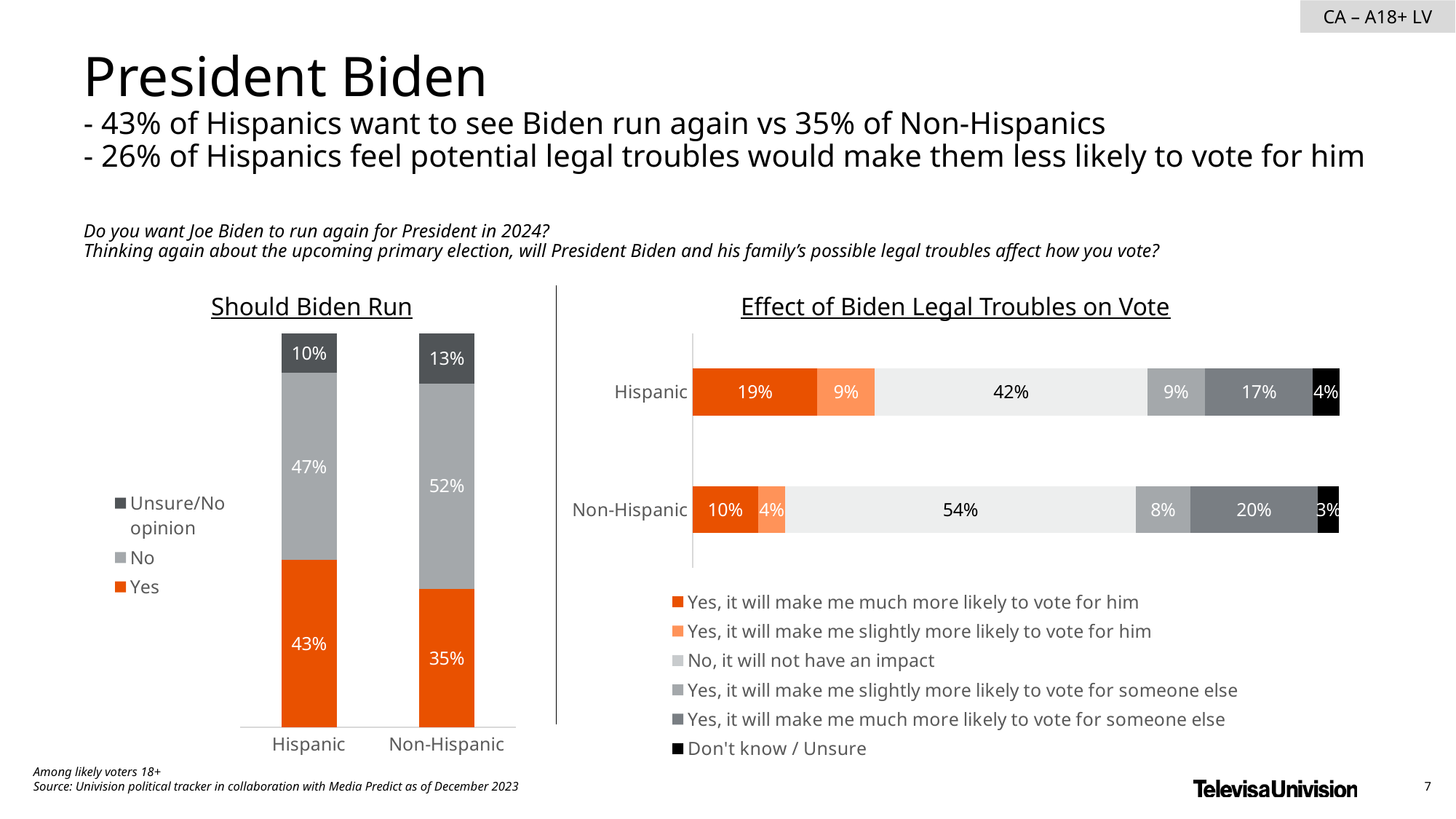
In the "Should Biden Run" chart, which group has the larger Yes value, Hispanic or Non-Hispanic? Hispanic In the "Should Biden Run" chart, what percentage of Hispanics answered Yes? 43% In the "Should Biden Run" chart, what percentage of Non-Hispanics answered No? 52% In the "Effect of Biden Legal Troubles on Vote" chart, how many series does the legend list? 6 In the "Should Biden Run" chart, what is the difference between the Unsure/No opinion values for Non-Hispanic and Hispanic? 3% In the "Effect of Biden Legal Troubles on Vote" chart, what percentage of Hispanics said it will not have an impact? 42% In the "Effect of Biden Legal Troubles on Vote" chart, what is the Don't know / Unsure value for Hispanic? 4% In the "Effect of Biden Legal Troubles on Vote" chart, which response category has the highest value for Non-Hispanic? No, it will not have an impact In the "Effect of Biden Legal Troubles on Vote" chart, what is the difference between the Hispanic and Non-Hispanic values for "much more likely to vote for him"? 9% In the "Effect of Biden Legal Troubles on Vote" chart, what percentage of Non-Hispanics said it will make them much more likely to vote for someone else? 20% What kind of chart is "Effect of Biden Legal Troubles on Vote"? Stacked bar chart In the "Should Biden Run" chart, how many series does the legend list? 3